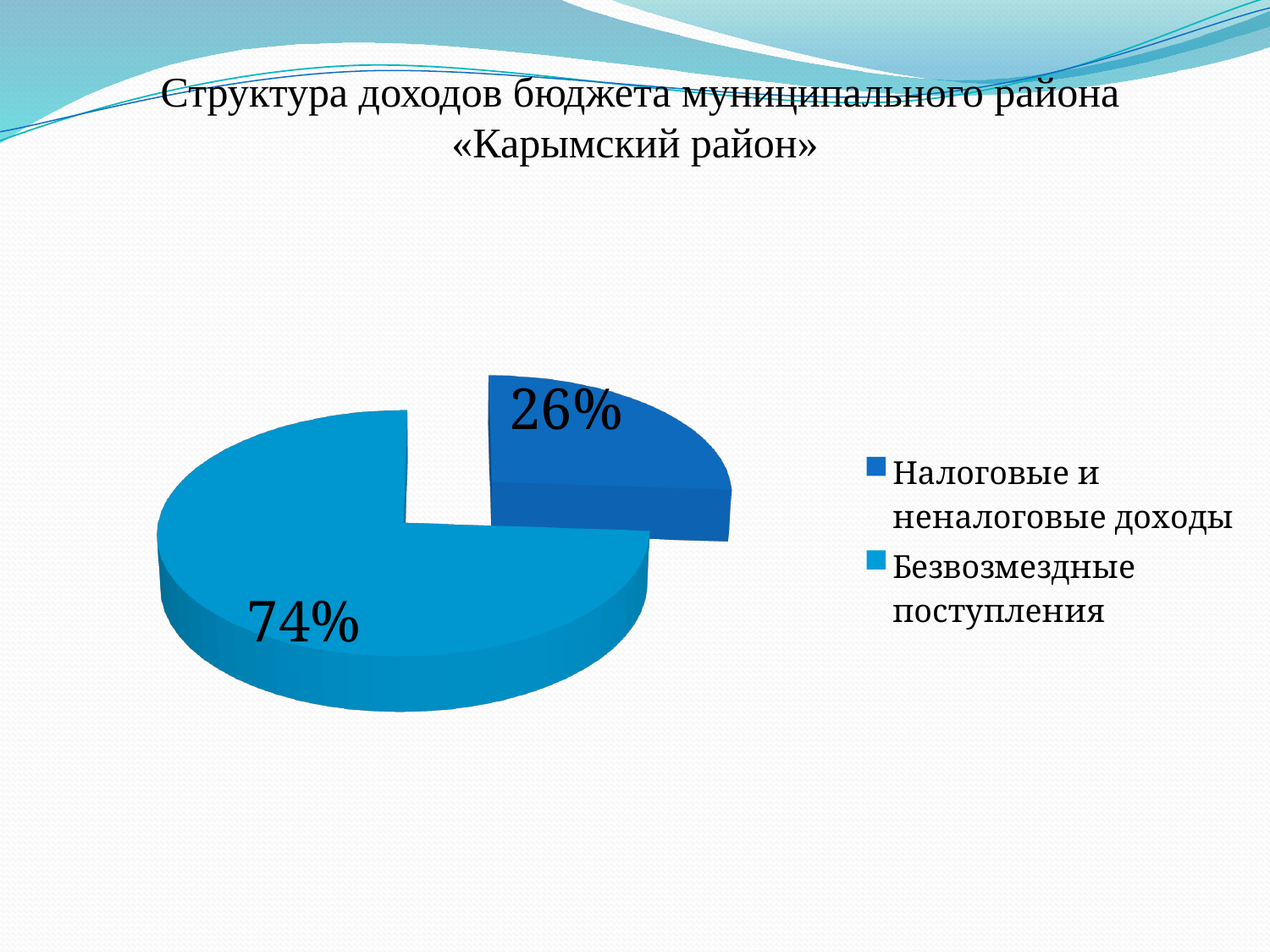
What share of the pie does «Налоговые и неналоговые доходы» represent? 26% What share of the pie does «Безвозмездные поступления» represent? 74% What is the title of the slide containing the chart? Структура доходов бюджета муниципального района «Карымский район» What kind of chart is shown on the slide? pie chart Which category has the largest slice of the pie? Безвозмездные поступления Which legend entry is shown in the darker blue colour? Налоговые и неналоговые доходы Which category has the smallest slice of the pie? Налоговые и неналоговые доходы How many entries does the legend list? 2 What is the difference in percentage points between «Безвозмездные поступления» and «Налоговые и неналоговые доходы»? 48 How many slices does the pie chart have? 2 Which is larger: «Налоговые и неналоговые доходы» or «Безвозмездные поступления»? Безвозмездные поступления